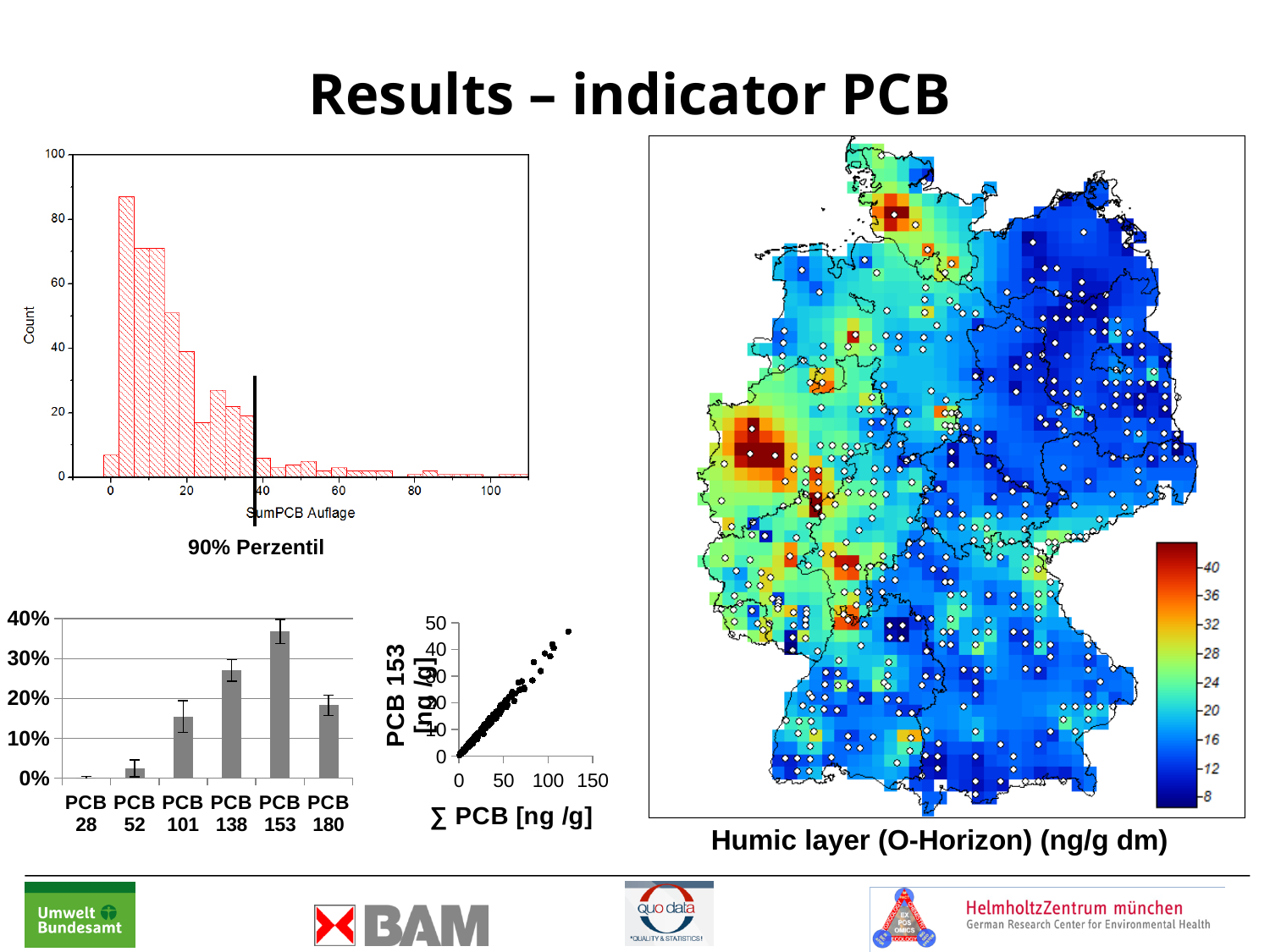
In the histogram at the top left, is the count of the tallest bar greater or less than 80? greater In the bar chart at the bottom left, is the value for PCB 52 greater or less than 10%? less In the bar chart at the bottom left, is the value for PCB 153 greater or less than 30%? greater In the bar chart at the bottom left, which is larger, the value for PCB 138 or the value for PCB 180? PCB 138 In the histogram at the top left, what does the vertical black line mark? 90% Perzentil In the bar chart at the bottom left, which PCB congener has the highest value? PCB 153 In the histogram at the top left, what is the label of the x axis? SumPCB Auflage What kind of chart is the chart at the bottom left showing PCB 28 to PCB 180? bar chart In the bar chart at the bottom left, how many PCB congeners are shown on the x axis? 6 In the bar chart at the bottom left, which PCB congener has the lowest value? PCB 28 In the scatter plot at the bottom middle, do the values of PCB 153 rise or fall as ∑ PCB increases? rise